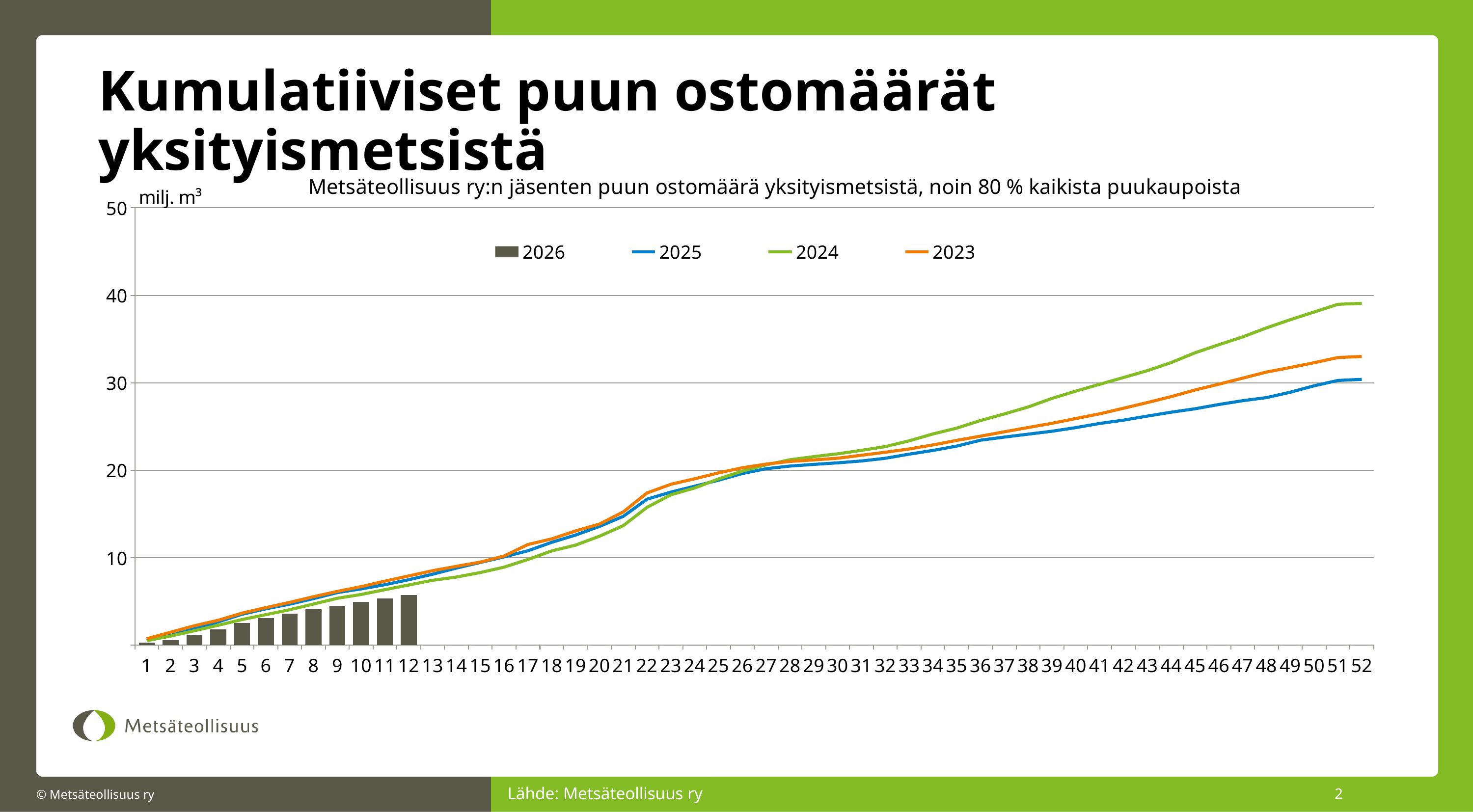
What unit is shown on the y axis? milj. m³ Is the value for 2024 at week 52 greater or less than 35? greater Which series has the highest value at week 52? 2024 Is the value for 2025 at week 52 greater or less than 35? less How many week categories are shown on the x axis? 52 How many bars are plotted for the 2026 series? 12 At week 52, which is larger: the value for 2023 or the value for 2025? 2023 Which years are listed in the chart legend? 2026, 2025, 2024, 2023 Do the line series rise or fall along the x axis? Rise Which line series has the lowest value at week 52? 2025 How many series does the legend list? 4 What kind of chart is shown on the slide? A combined bar and line chart